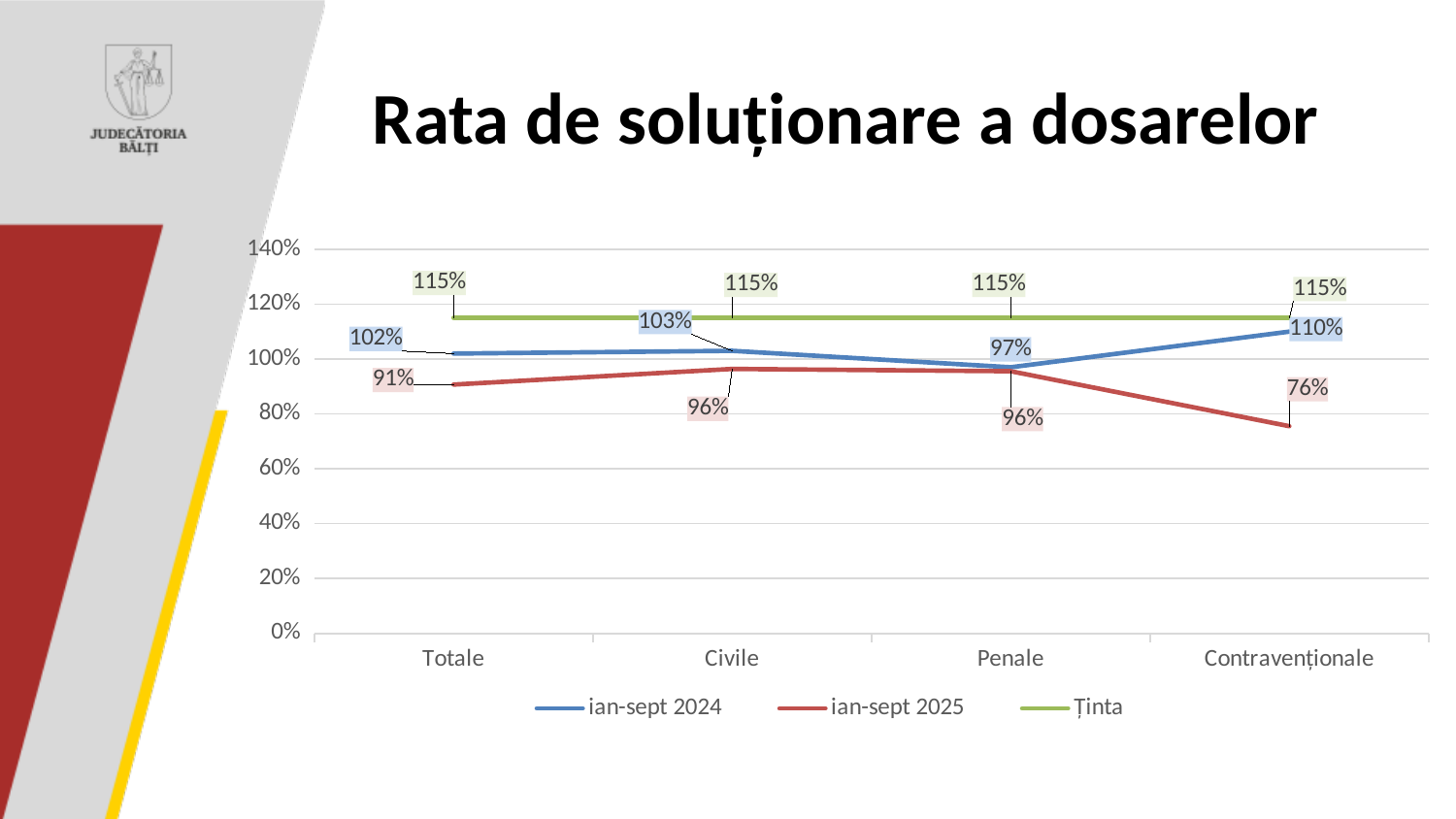
Which is larger for Civile: the ian-sept 2024 value or the ian-sept 2025 value? ian-sept 2024 What is the Ținta value for Civile? 115% What is the value for Penale in the ian-sept 2024 series? 97% Which category has the lowest value in the ian-sept 2025 series? Contravenționale What is the value for Totale in the ian-sept 2024 series? 102% How many series does the legend list? 3 What is the value for Contravenționale in the ian-sept 2025 series? 76% What kind of chart is shown on the slide? line chart What is the difference between the ian-sept 2024 and ian-sept 2025 values for Contravenționale? 34% How many categories are shown on the x axis? 4 What is the title of the chart? Rata de soluționare a dosarelor Which category has the highest value in the ian-sept 2024 series? Contravenționale